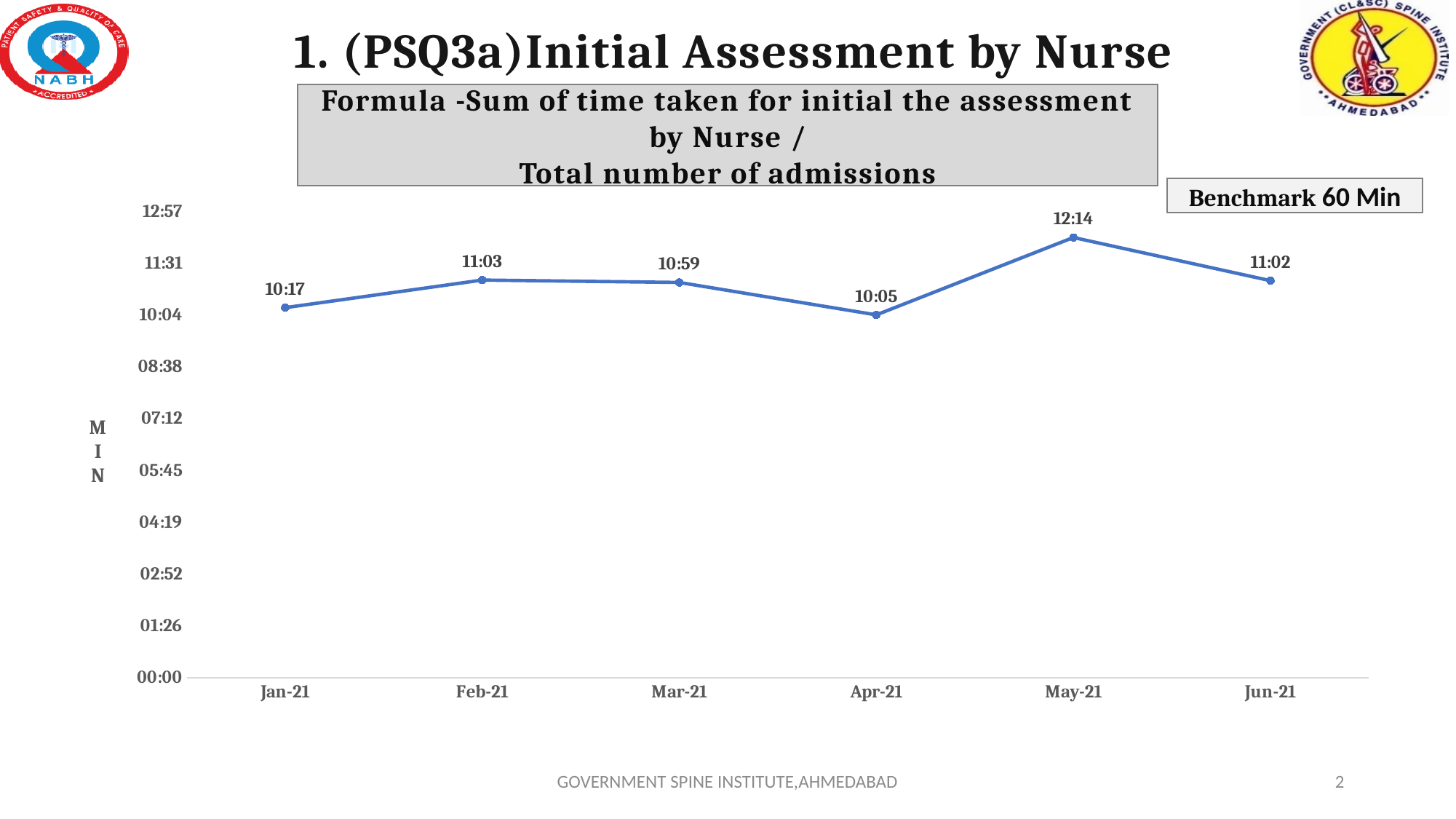
Which is larger, the value for Mar-21 or the value for Apr-21? Mar-21 What type of chart is shown on the slide? line chart What is the label on the vertical axis of the chart? MIN Which month has the highest value? May-21 What is the benchmark stated on the slide? 60 Min What is the value for Jan-21? 10:17 What is the value for Jun-21? 11:02 What is the value for Apr-21? 10:05 How many months are plotted on the chart? 6 Does the value rise or fall from Mar-21 to Apr-21? fall Which month has the lowest value? Apr-21 Does the value rise or fall from Apr-21 to May-21? rise